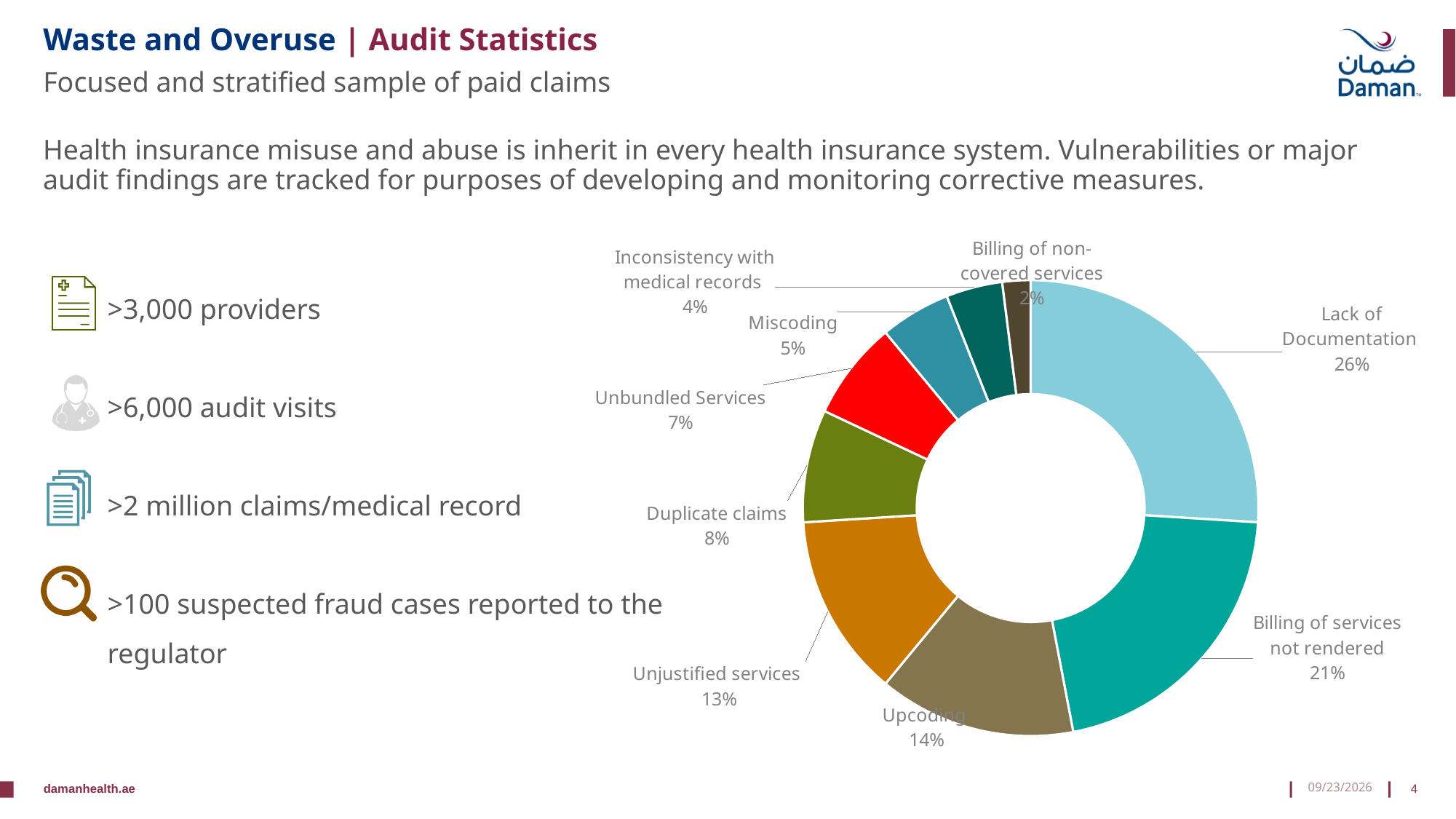
What is the value for Upcoding? 14% Which category has the smallest share of the chart? Billing of non-covered services What kind of chart is shown on the slide? Doughnut chart Which category has the largest share of the chart? Lack of Documentation What share of the chart is Lack of Documentation? 26% What is the value for Unjustified services? 13% How many categories are shown in the chart? 9 Which is larger, Duplicate claims or Unbundled Services? Duplicate claims What colour is the Unbundled Services slice? Red What is the value for Billing of services not rendered? 21% What is the value for Miscoding? 5% What is the difference between Lack of Documentation and Billing of services not rendered? 5%